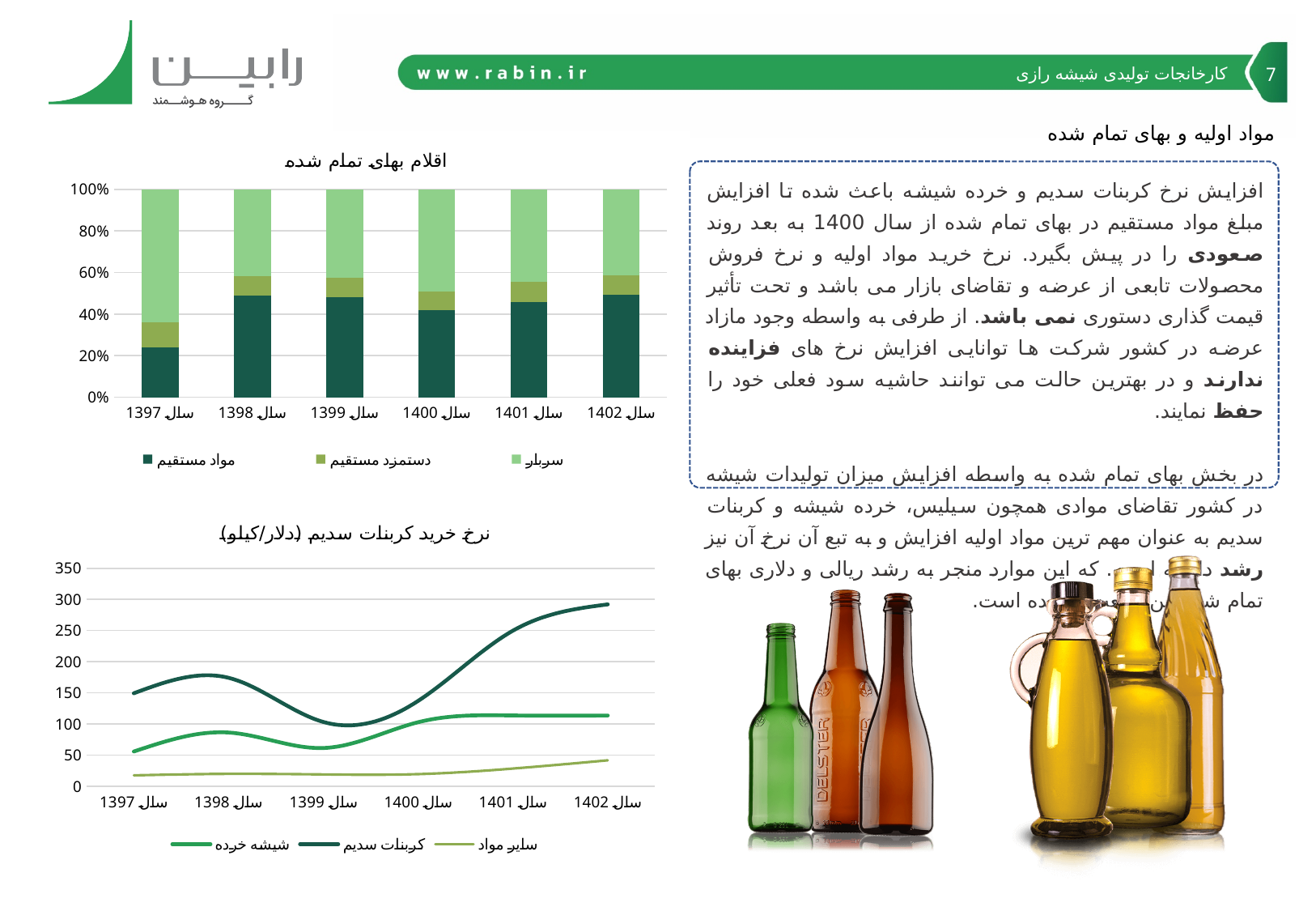
In the chart "نرخ خرید کربنات سدیم (دلار/کیلو)", which series has the lowest value in سال 1402? سایر مواد In the chart "اقلام بهای تمام شده", how many series does the legend list? 3 In the chart "اقلام بهای تمام شده", which series has the largest share in سال 1397? سربار In the chart "اقلام بهای تمام شده", is the share of مواد مستقیم in سال 1397 greater or less than 40%? less In the chart "نرخ خرید کربنات سدیم (دلار/کیلو)", is the value of سایر مواد in سال 1397 greater or less than 50? less In the chart "نرخ خرید کربنات سدیم (دلار/کیلو)", how many series does the legend list? 3 What kind of chart is the bottom-left chart titled "نرخ خرید کربنات سدیم (دلار/کیلو)"? line chart In the chart "اقلام بهای تمام شده", is the share of مواد مستقیم in سال 1402 greater or less than 40%? greater In the chart "اقلام بهای تمام شده", how many years are shown on the x axis? 6 In the chart "نرخ خرید کربنات سدیم (دلار/کیلو)", does the value of کربنات سدیم rise or fall from سال 1399 to سال 1402? rise What kind of chart is the top-left chart titled "اقلام بهای تمام شده"? stacked bar chart